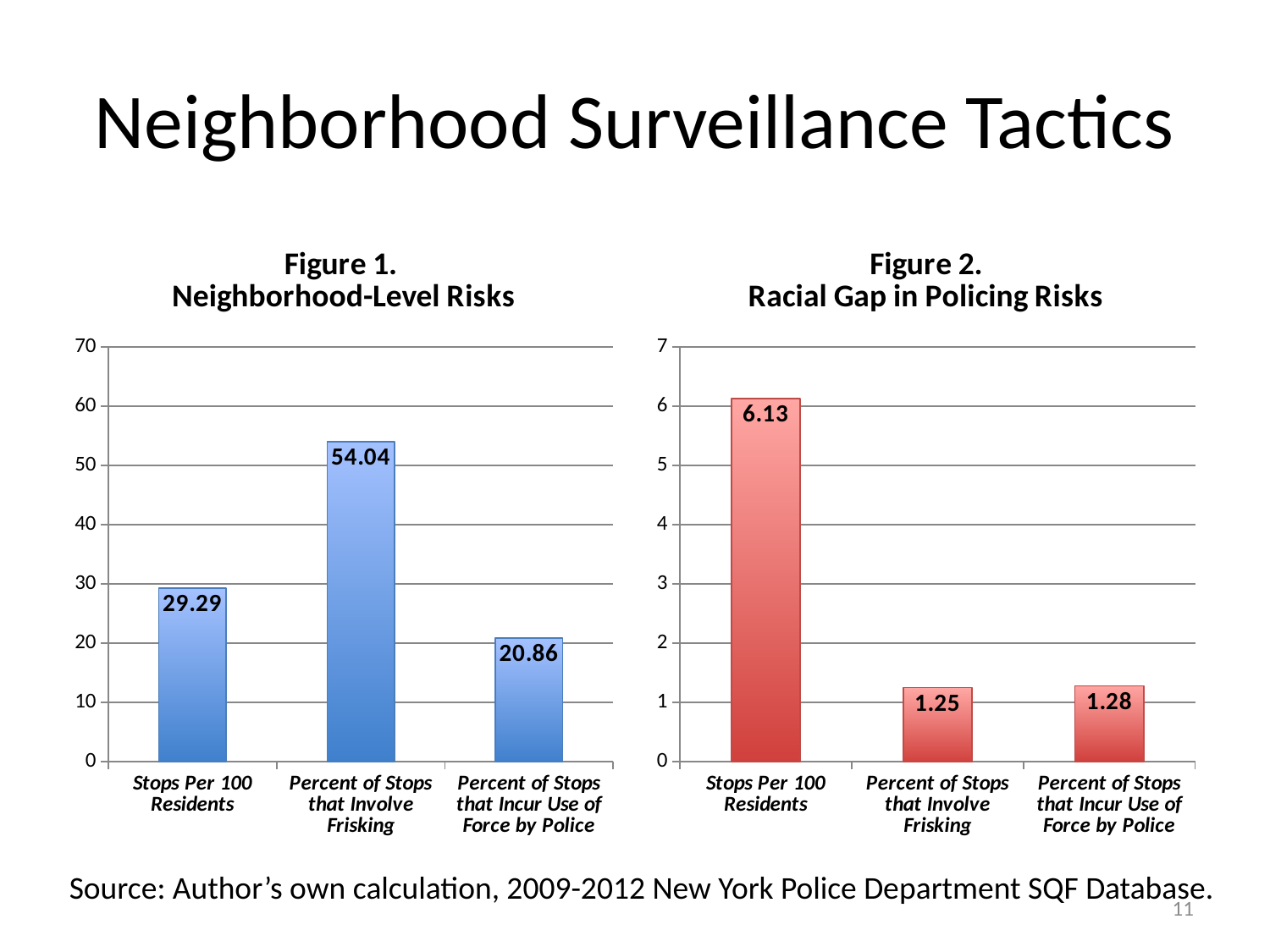
In Figure 1 (Neighborhood-Level Risks), what is the difference between Percent of Stops that Involve Frisking and Stops Per 100 Residents? 24.75 In Figure 1 (Neighborhood-Level Risks), what is the value for Percent of Stops that Involve Frisking? 54.04 In Figure 2 (Racial Gap in Policing Risks), which category has the highest value? Stops Per 100 Residents How many categories are shown in Figure 2 (Racial Gap in Policing Risks)? 3 In Figure 1 (Neighborhood-Level Risks), which category has the lowest value? Percent of Stops that Incur Use of Force by Police In Figure 1 (Neighborhood-Level Risks), which is larger: Stops Per 100 Residents or Percent of Stops that Incur Use of Force by Police? Stops Per 100 Residents What type of chart is Figure 1 (Neighborhood-Level Risks)? Bar chart In Figure 1 (Neighborhood-Level Risks), what is the value for Stops Per 100 Residents? 29.29 In Figure 2 (Racial Gap in Policing Risks), what is the value for Stops Per 100 Residents? 6.13 In Figure 1 (Neighborhood-Level Risks), which category has the highest value? Percent of Stops that Involve Frisking In Figure 2 (Racial Gap in Policing Risks), what is the value for Percent of Stops that Incur Use of Force by Police? 1.28 In Figure 2 (Racial Gap in Policing Risks), what is the difference between Stops Per 100 Residents and Percent of Stops that Involve Frisking? 4.88